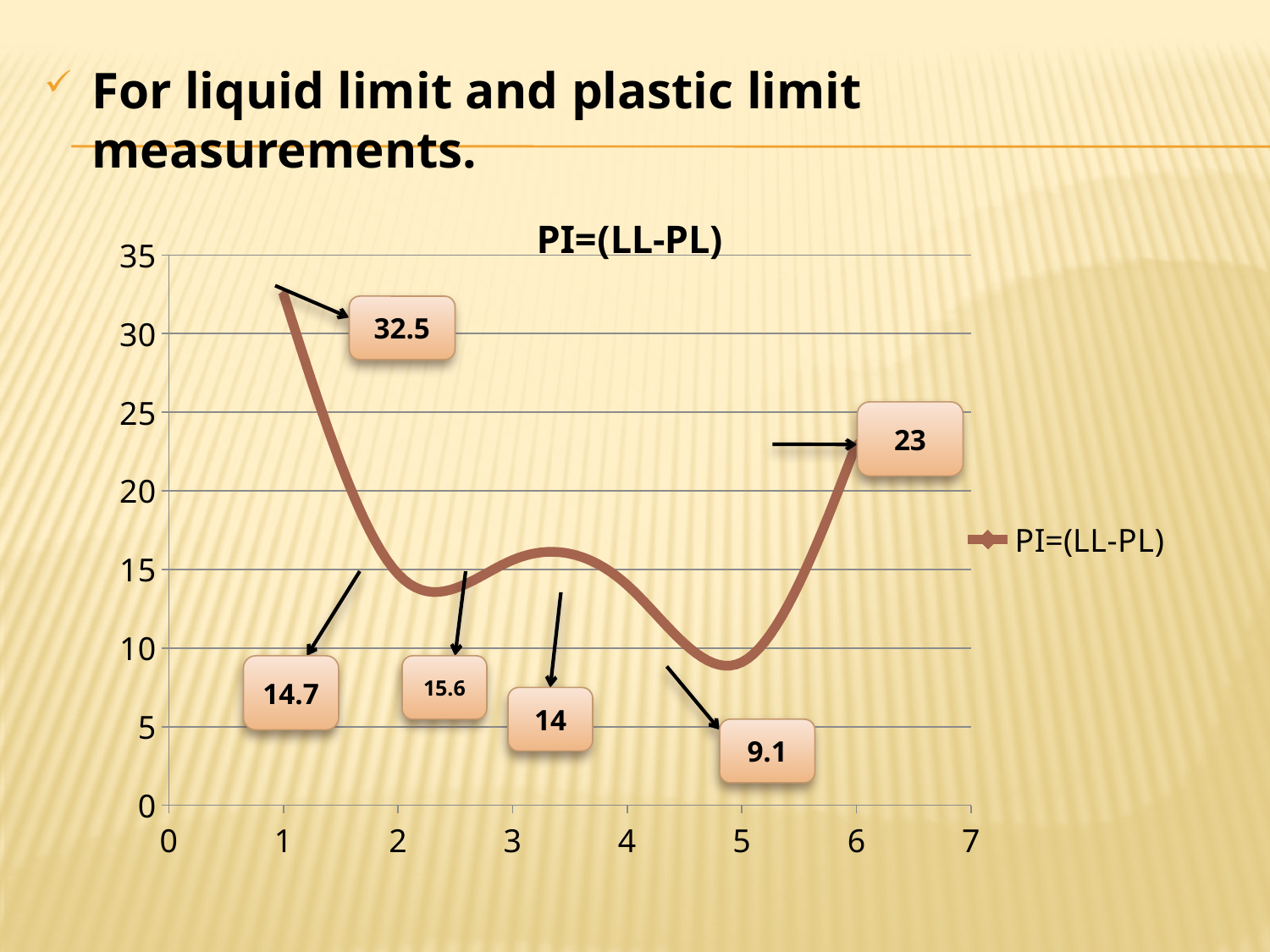
What is the title of the chart? PI=(LL-PL) What is the difference between the highest labelled value (32.5) and the lowest labelled value (9.1)? 23.4 What is the lowest labelled value on the chart? 9.1 Which is larger, the value at x = 1 or the value at x = 6? x = 1 Does the line rise or fall between x = 5 and x = 6? rise What is the value labelled at x = 6? 23 What is the value labelled at x = 5? 9.1 What is the value labelled at x = 1? 32.5 What is the highest labelled value on the chart? 32.5 How many series does the legend list? 1 How many data points are labelled with values on the chart? 6 What type of chart is shown on the slide? line chart